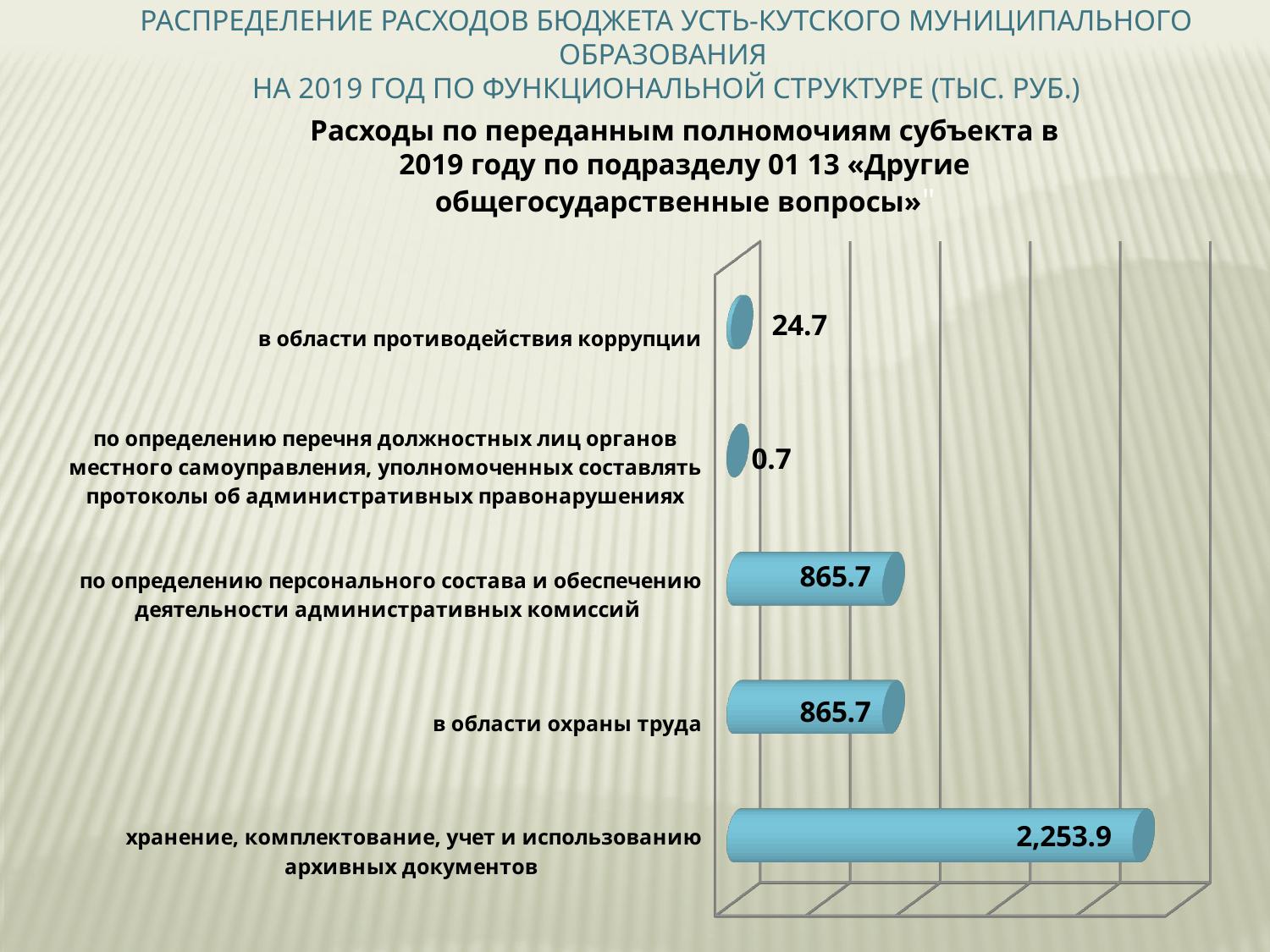
What is the title of the chart? Расходы по переданным полномочиям субъекта в 2019 году по подразделу 01 13 «Другие общегосударственные вопросы» What is the difference between the value for «хранение, комплектование, учет и использованию архивных документов» and the value for «в области охраны труда»? 1,388.2 Which category has the lowest value? по определению перечня должностных лиц органов местного самоуправления, уполномоченных составлять протоколы об административных правонарушениях What is the value for «в области противодействия коррупции»? 24.7 What is the value for «в области охраны труда»? 865.7 What is the value for «по определению перечня должностных лиц органов местного самоуправления, уполномоченных составлять протоколы об административных правонарушениях»? 0.7 Which is larger: the value for «в области противодействия коррупции» or the value for «по определению персонального состава и обеспечению деятельности административных комиссий»? по определению персонального состава и обеспечению деятельности административных комиссий What is the difference between the value for «в области противодействия коррупции» and the value for «по определению перечня должностных лиц...»? 24 What is the value for «хранение, комплектование, учет и использованию архивных документов»? 2,253.9 How many categories are shown in the chart? 5 What kind of chart is shown on the slide? bar chart Which category has the highest value? хранение, комплектование, учет и использованию архивных документов